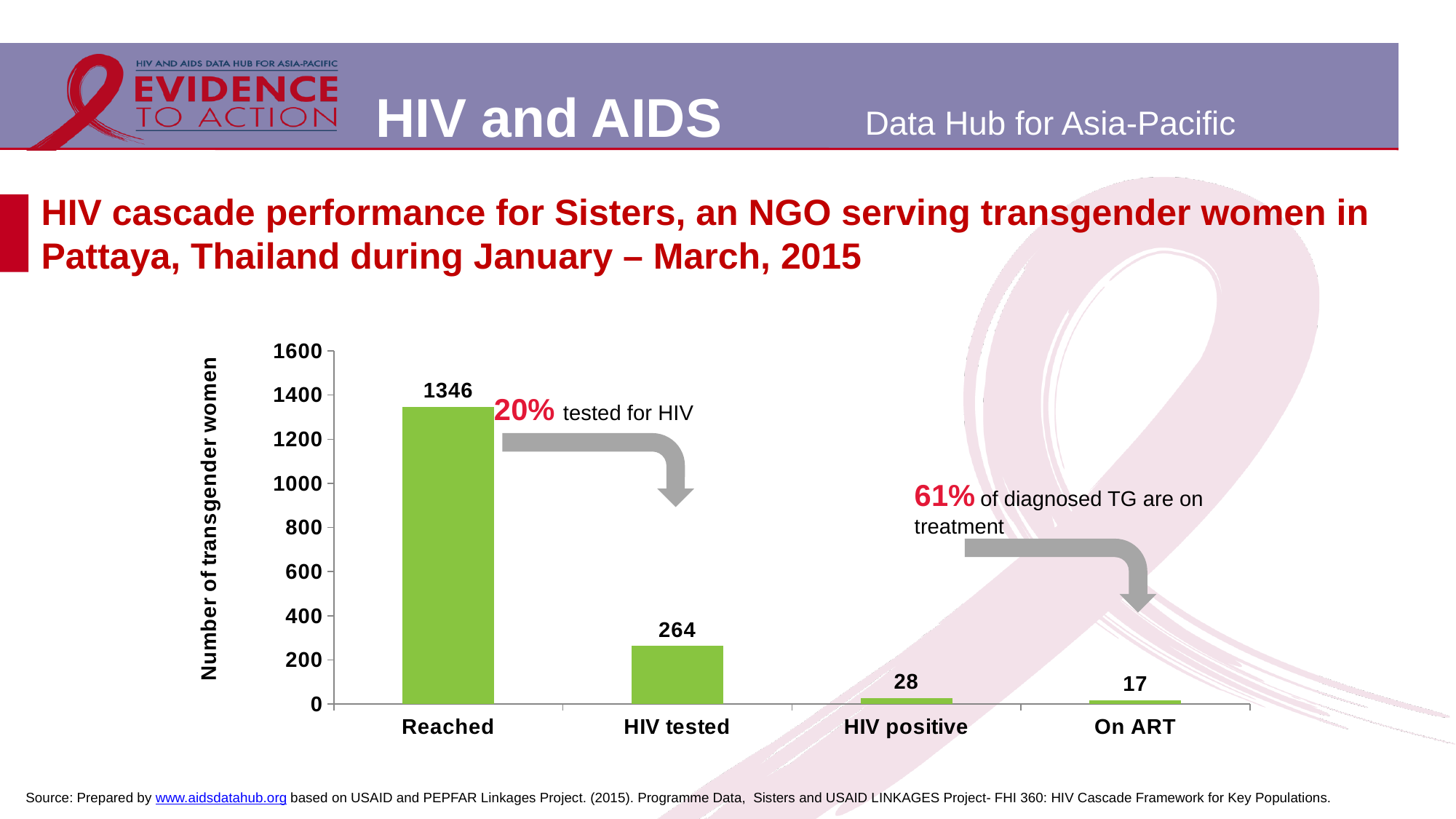
What kind of chart is shown? Bar chart How many transgender women were reached? 1346 What is the difference between the Reached and HIV tested values? 1082 What is the value for HIV positive? 28 What is the difference between the HIV positive and On ART values? 11 What is the value for On ART? 17 How many categories are shown on the x axis? 4 Do the values rise or fall from left to right along the x axis? Fall What is the value for HIV tested? 264 Which is larger, the value for HIV tested or the value for HIV positive? HIV tested Which category has the lowest value? On ART Which category has the highest value? Reached